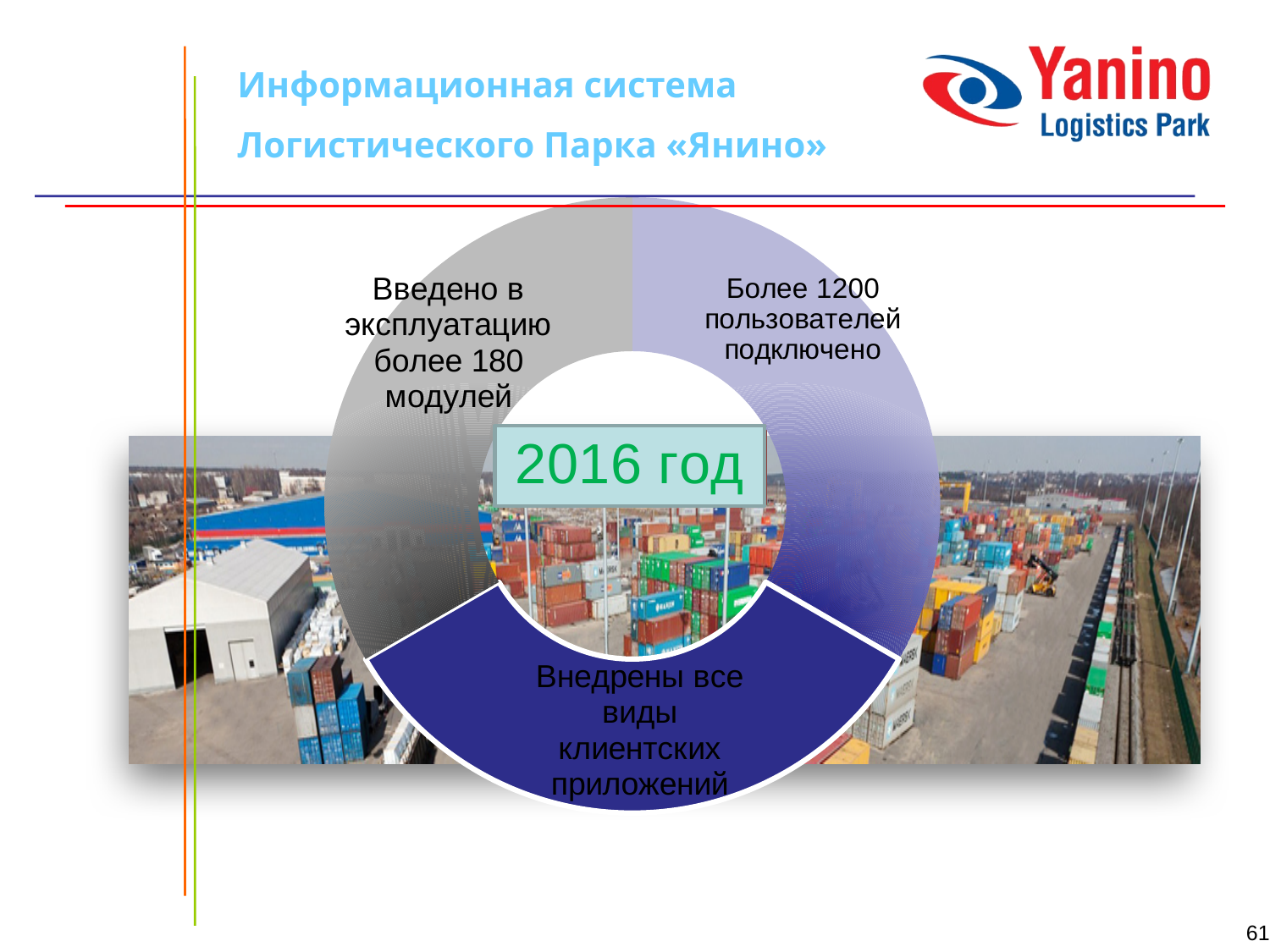
What does the dark blue segment of the doughnut chart say? Внедрены все виды клиентских приложений According to the doughnut chart, how many users are connected? Более 1200 What does the light purple segment of the doughnut chart say? Более 1200 пользователей подключено According to the doughnut chart, how many modules have been put into operation? более 180 How many segments does the doughnut chart have? 3 What text is shown in the centre of the doughnut chart? 2016 год Which colour is the segment at the bottom of the doughnut chart? dark blue What does the grey segment of the doughnut chart say? Введено в эксплуатацию более 180 модулей What kind of chart is shown on the slide? doughnut (pie) chart